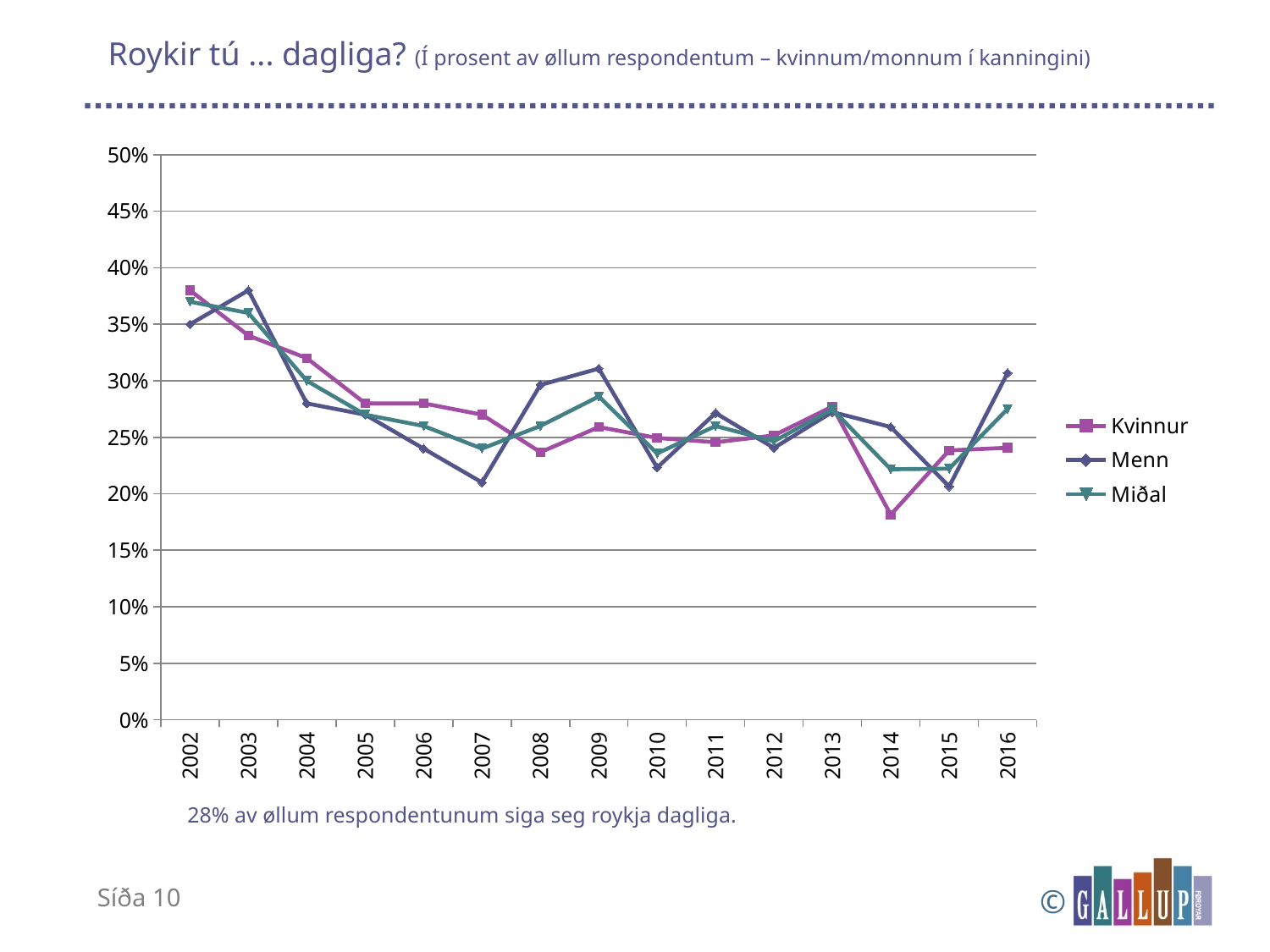
How many years are plotted along the x axis? 15 Is the value for Kvinnur in 2014 greater or less than 20%? less Does the Kvinnur series rise or fall from 2002 to 2005? fall In which year does the Kvinnur series reach its lowest value? 2014 Is the value for Menn in 2007 greater or less than 25%? less In 2009, which series has the larger value, Menn or Kvinnur? Menn Which series are listed in the legend? Kvinnur, Menn, Miðal Is the value for Menn in 2016 greater or less than 30%? greater How many series does the legend list? 3 In which year does the Menn series reach its highest value? 2003 What kind of chart is shown on the slide? line chart In which year does the Kvinnur series reach its highest value? 2002